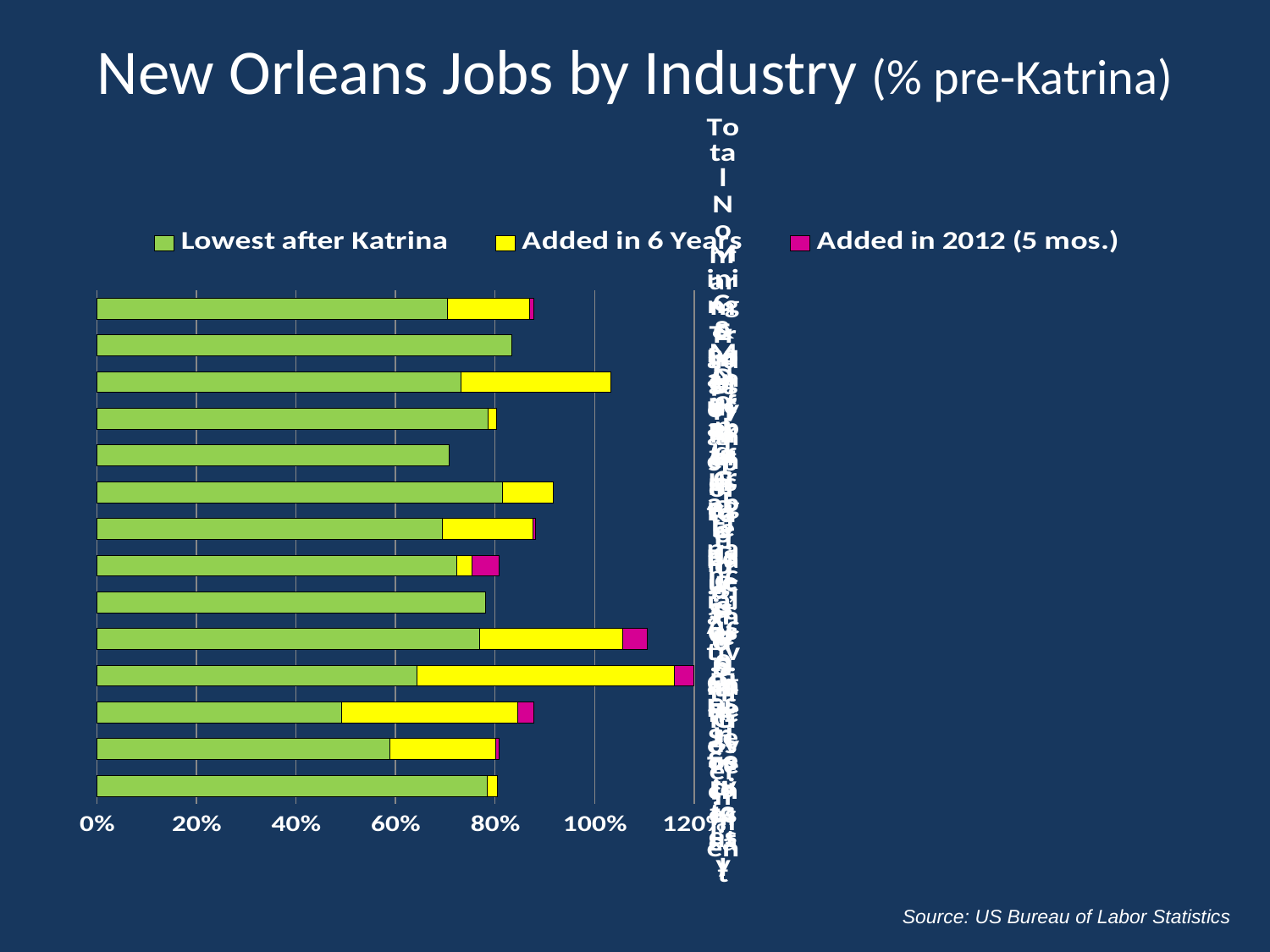
How many bars include a pink 'Added in 2012 (5 mos.)' segment? 7 Is the total of the shortest bar in the chart greater or less than 80%? less How many bars (industries) are plotted in the chart? 14 What are the three series named in the legend? Lowest after Katrina, Added in 6 Years, Added in 2012 (5 mos.) How many series does the legend list? 3 What colour represents the 'Added in 2012 (5 mos.)' series? pink What kind of chart is shown on the slide? bar chart Is the total of the longest bar in the chart greater or less than 100%? greater